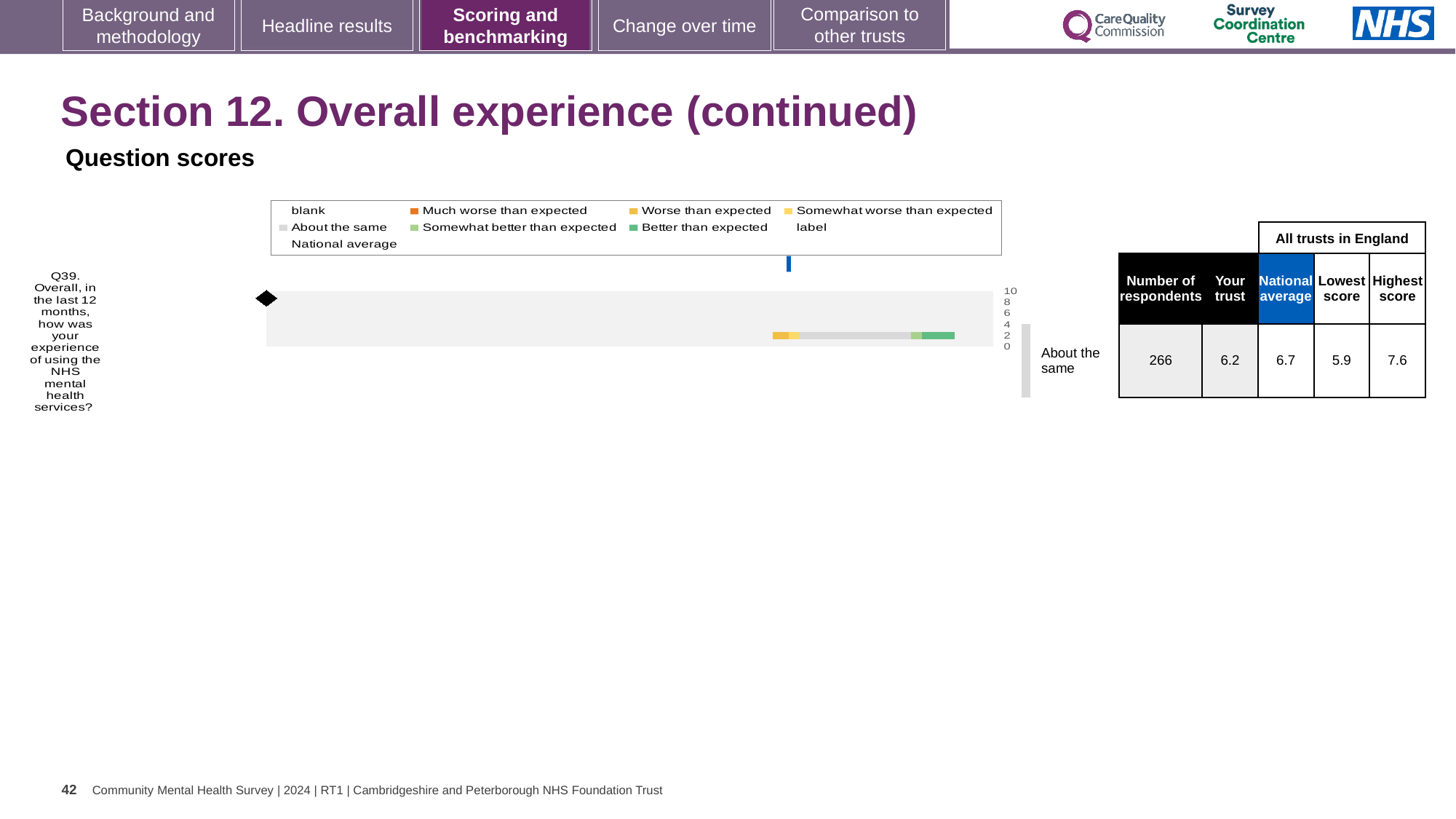
How many questions (categories) are plotted on the chart? 1 How many entries does the chart's legend list? 9 What benchmark category label is shown to the right of the bar for Q39? About the same For Q39, which is larger: the 'Your trust' score or the national average? National average According to the table beside the chart, what is the highest score among all trusts in England for Q39? 7.6 According to the table beside the chart, what is the 'Your trust' score for Q39? 6.2 For Q39, what is the difference between the highest score and the lowest score among all trusts in England? 1.7 Which question is plotted on the chart? Q39. Overall, in the last 12 months, how was your experience of using the NHS mental health services? According to the table beside the chart, what is the lowest score among all trusts in England for Q39? 5.9 What kind of chart is shown on the slide? bar chart According to the table beside the chart, how many respondents answered Q39? 266 According to the table beside the chart, what is the national average score for Q39? 6.7